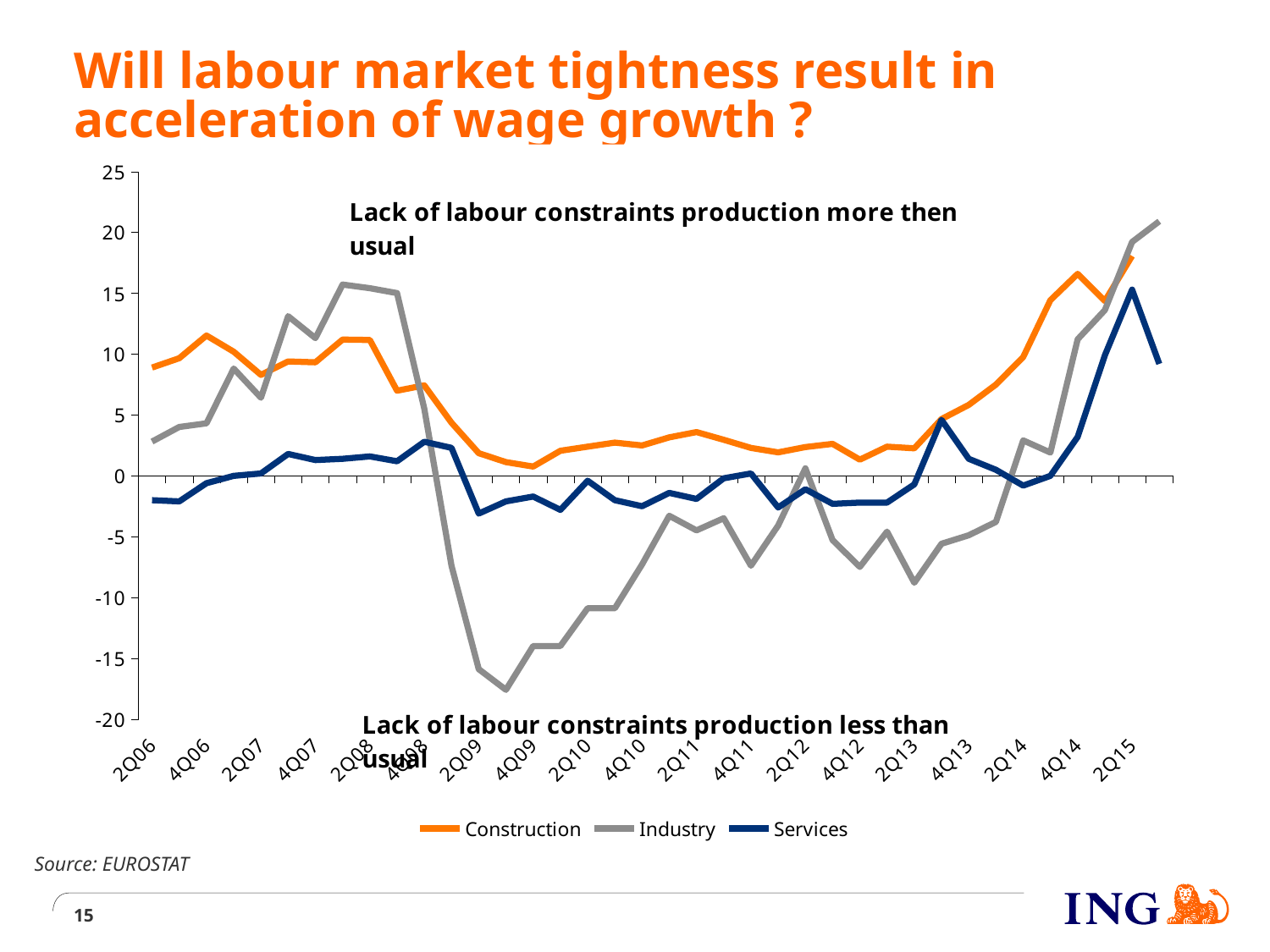
Is the value for Industry at 2Q08 greater or less than 10? greater How many series does the legend list? 3 What kind of chart is shown on the slide? line chart Is the value for Industry at 2Q09 greater or less than -10? less What is the source cited for the chart? EUROSTAT Which series are listed in the legend? Construction, Industry, Services Is the value for Services at 2Q15 greater or less than 10? greater Does the Industry series rise or fall between 2Q08 and 2Q09? fall Which series has the lowest value at 2Q09? Industry At 2Q06, which is larger: the value for Construction or the value for Services? Construction Which series has the highest value at 4Q14? Construction